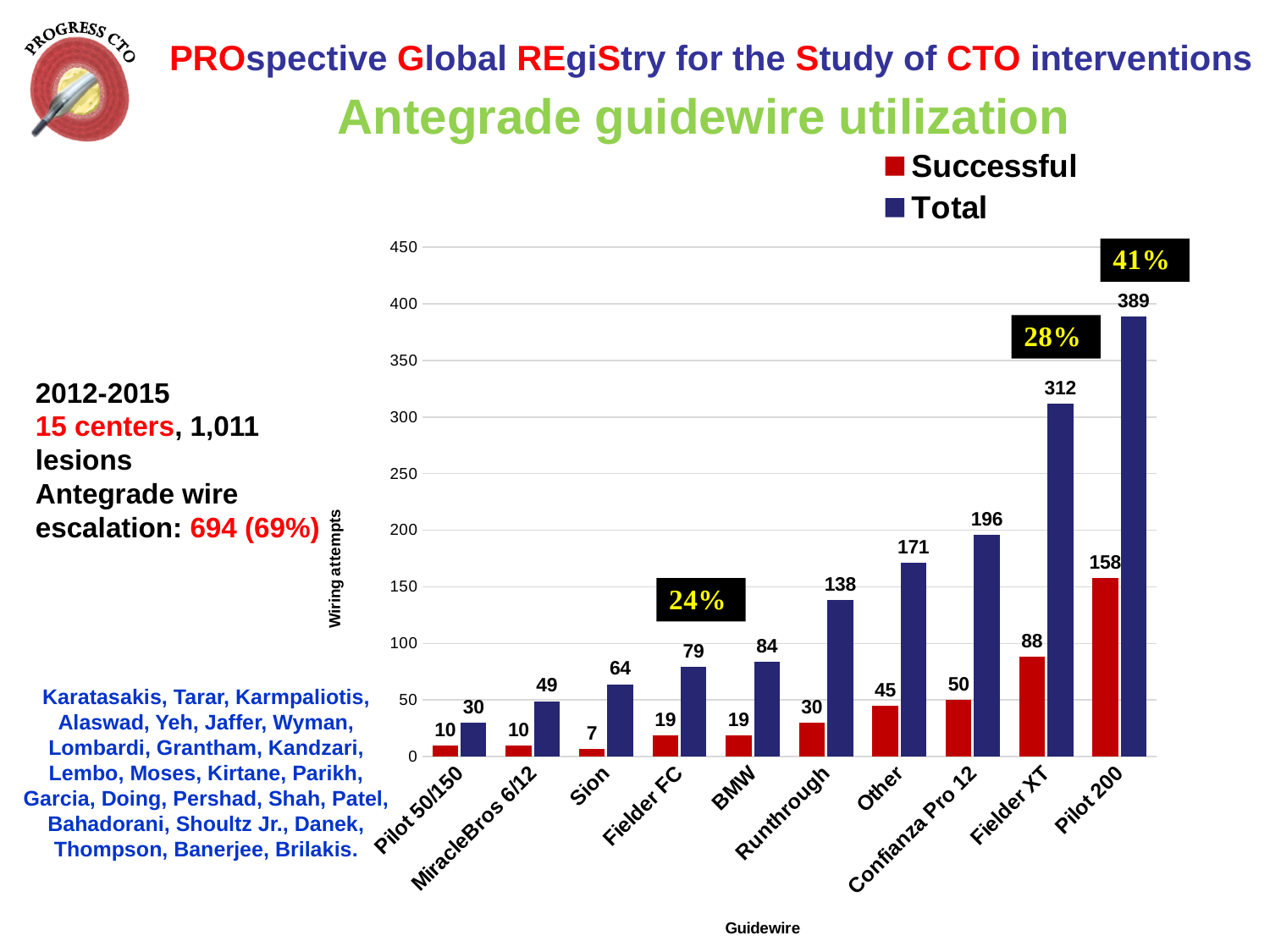
Which guidewire has the highest Total value? Pilot 200 Is the Total value for Fielder XT greater or less than 300? greater What is the difference between the Total and Successful values for Pilot 200? 231 What is the Successful value for Fielder XT? 88 What is the Total value for Pilot 200? 389 Which guidewire has the lowest Successful value? Sion What kind of chart is shown on the slide? bar chart What is the label of the y axis? Wiring attempts How many series does the legend list? 2 How many guidewire categories are shown on the x axis? 10 What is the Total value for Runthrough? 138 Which is larger, the Total value for Other or the Total value for Confianza Pro 12? Confianza Pro 12